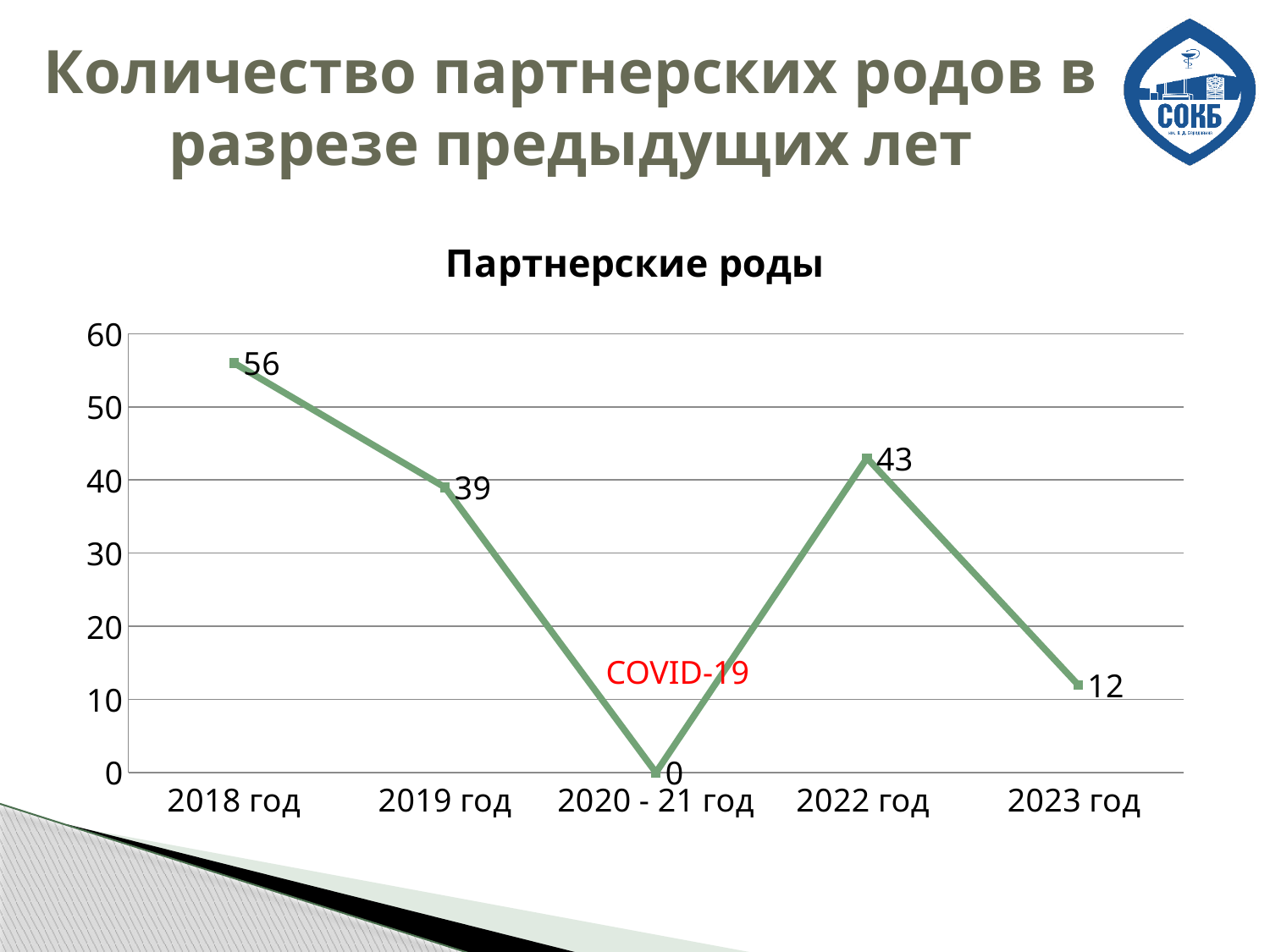
How many categories are shown on the x axis? 5 Which is larger, the value for 2019 год or the value for 2022 год? 2022 год What is the difference between the values for 2022 год and 2023 год? 31 What is the difference between the values for 2018 год and 2019 год? 17 What is the value for 2022 год? 43 What is the title of the chart? Партнерские роды Which category has the lowest value? 2020 - 21 год Do the values rise or fall from 2018 год to 2019 год? fall What is the value for 2020 - 21 год? 0 What is the value for 2018 год? 56 What kind of chart is this? line chart Which category has the highest value? 2018 год